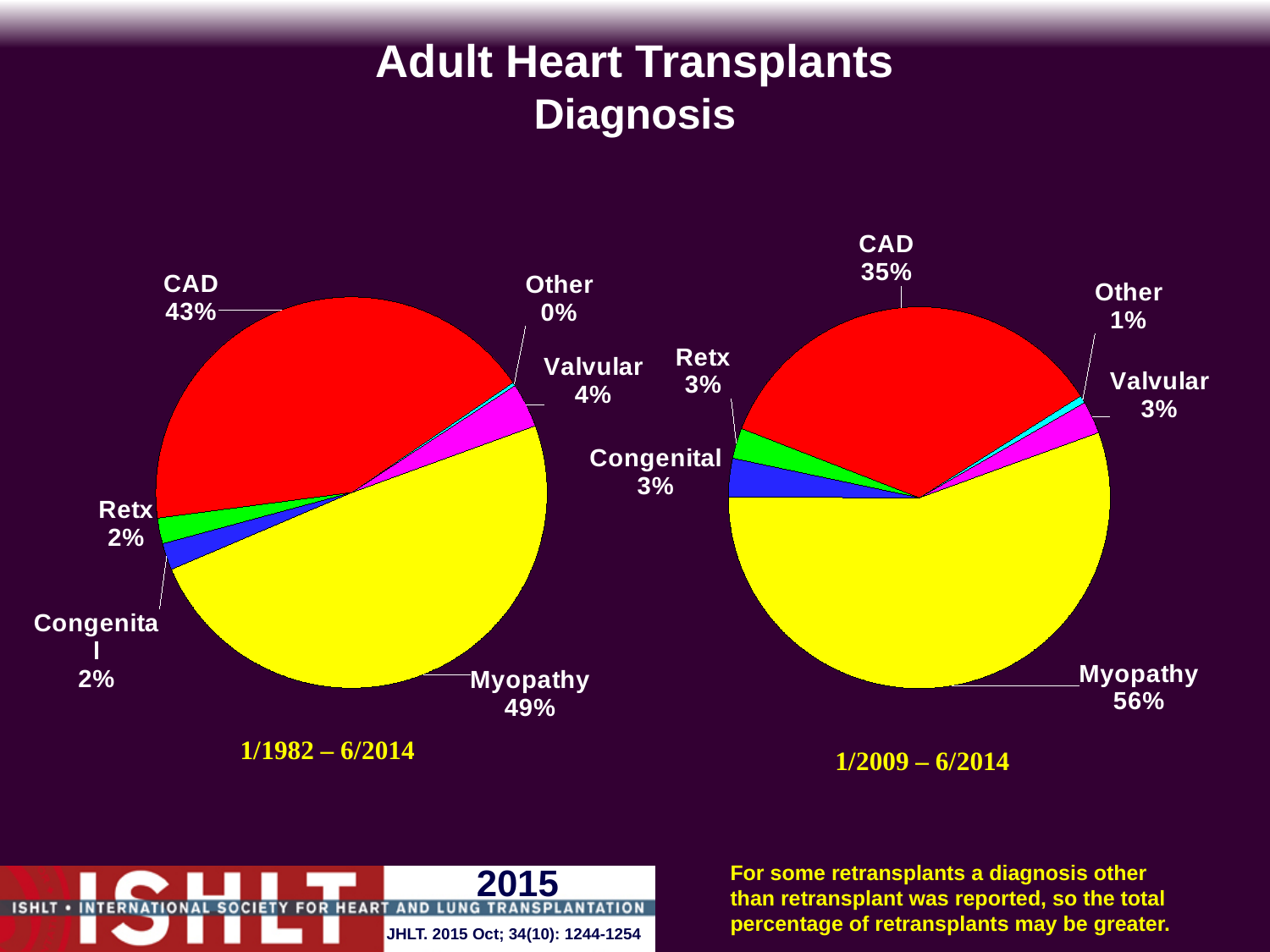
What type of chart is used on this slide? Pie chart In the 1/1982 – 6/2014 pie chart, which diagnosis has the smallest share? Other Which is larger: the CAD share in the 1/1982 – 6/2014 chart or the CAD share in the 1/2009 – 6/2014 chart? 1/1982 – 6/2014 In the 1/2009 – 6/2014 pie chart, what percentage is CAD? 35% What is the difference between the Myopathy share in the 1/2009 – 6/2014 chart and the Myopathy share in the 1/1982 – 6/2014 chart? 7% In the 1/2009 – 6/2014 pie chart, what percentage is Other? 1% In the 1/1982 – 6/2014 pie chart, what percentage is Myopathy? 49% In the 1/2009 – 6/2014 pie chart, which diagnosis has the largest share? Myopathy How many diagnosis categories are shown in the 1/2009 – 6/2014 pie chart? 6 In the 1/1982 – 6/2014 pie chart, what percentage is Valvular? 4% What colour is the Myopathy slice in both pie charts? Yellow In the 1/1982 – 6/2014 pie chart, what is the difference between the CAD and Myopathy shares? 6%